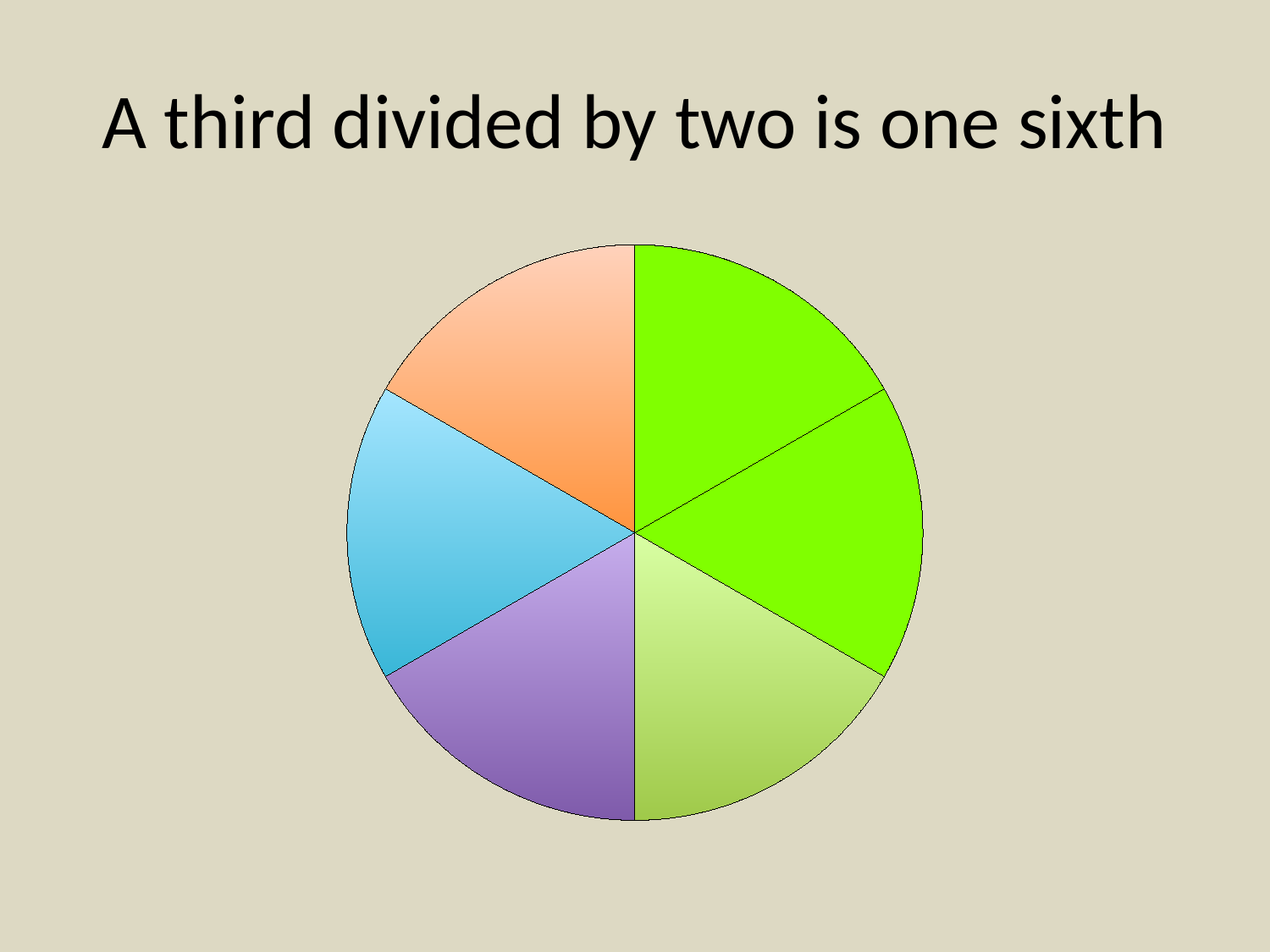
What is the title of the slide above the pie chart? A third divided by two is one sixth How many slices of the pie chart are coloured bright green? 2 What kind of chart is shown on the slide? pie chart How many slices does the pie chart have? 6 According to the slide, what fraction of the whole does each equal slice of the pie represent? one sixth